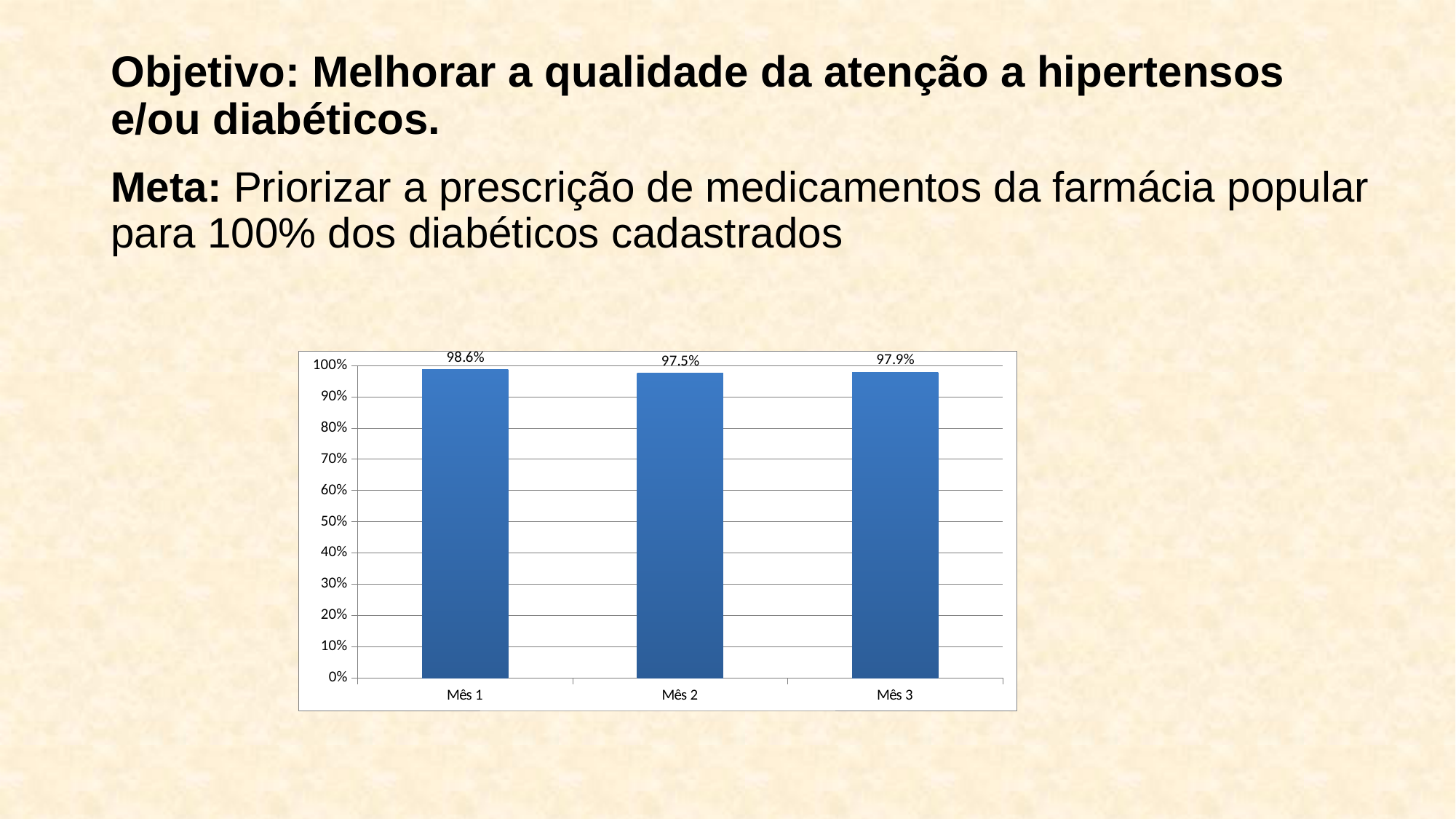
How many months are shown on the chart? 3 What is the value for Mês 3? 97.9% What is the difference between the values for Mês 3 and Mês 2? 0.4 percentage points What kind of chart is shown on the slide? bar chart Which month has the lowest value? Mês 2 Which month has the highest value? Mês 1 Is the value for Mês 2 greater or less than 90%? greater Does the value rise or fall from Mês 1 to Mês 2? fall What is the value for Mês 2? 97.5% Which is larger, the value for Mês 1 or the value for Mês 3? Mês 1 What is the difference between the values for Mês 1 and Mês 2? 1.1 percentage points What is the value for Mês 1? 98.6%